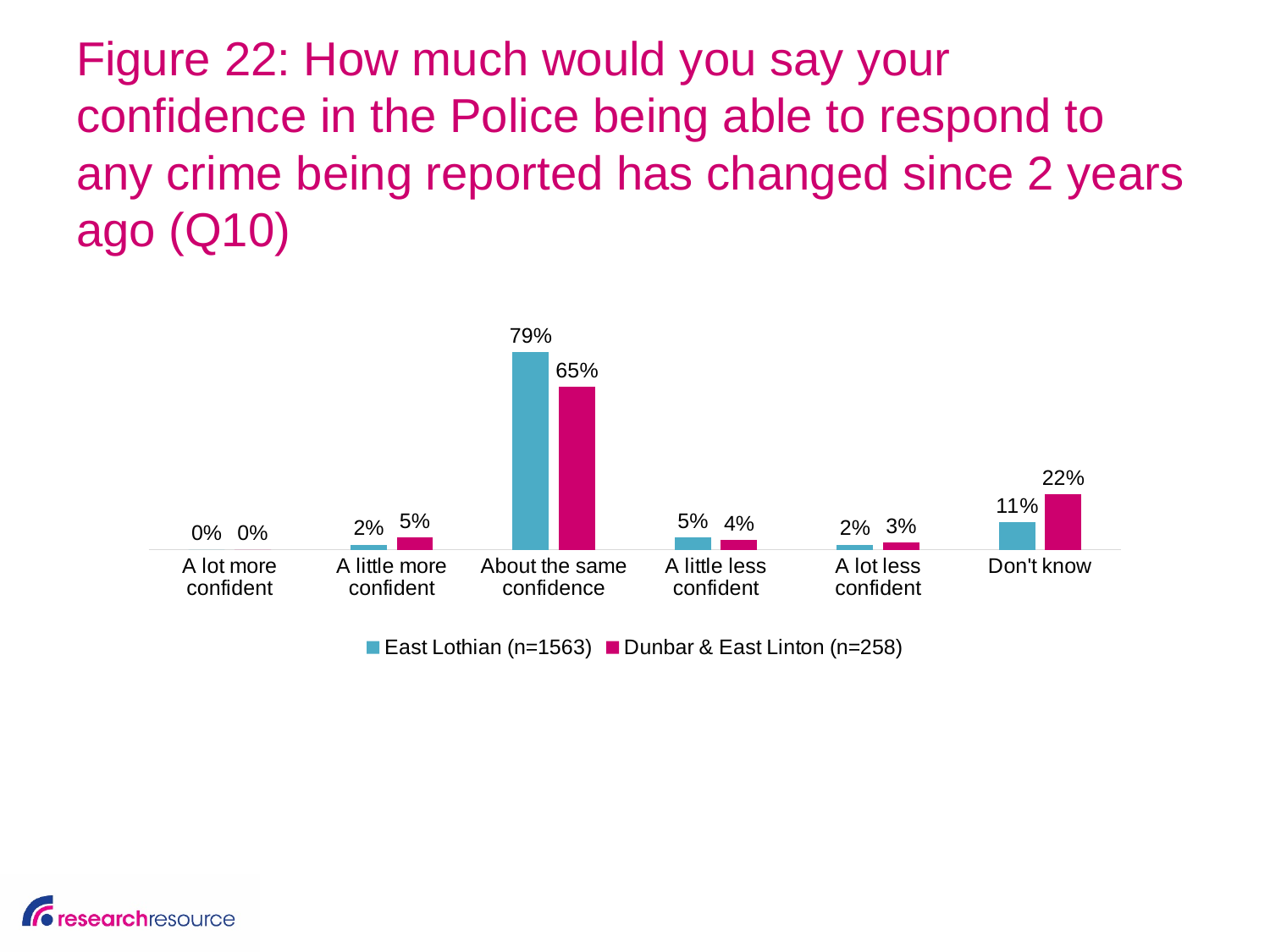
What kind of chart is shown on the slide? Bar chart What is the value for Dunbar & East Linton for 'A little more confident'? 5% Which category has the highest value for East Lothian? About the same confidence How many series does the legend list? 2 How many categories are shown on the x axis? 6 What is the value for East Lothian for 'About the same confidence'? 79% What is the difference between East Lothian and Dunbar & East Linton for 'About the same confidence'? 14 percentage points What is the sample size (n) for the Dunbar & East Linton series shown in the legend? 258 What is the difference between Dunbar & East Linton and East Lothian for 'Don't know'? 11 percentage points For 'A little less confident', which series has the larger value, East Lothian or Dunbar & East Linton? East Lothian Which category has the lowest value for Dunbar & East Linton? A lot more confident What is the value for Dunbar & East Linton for 'Don't know'? 22%